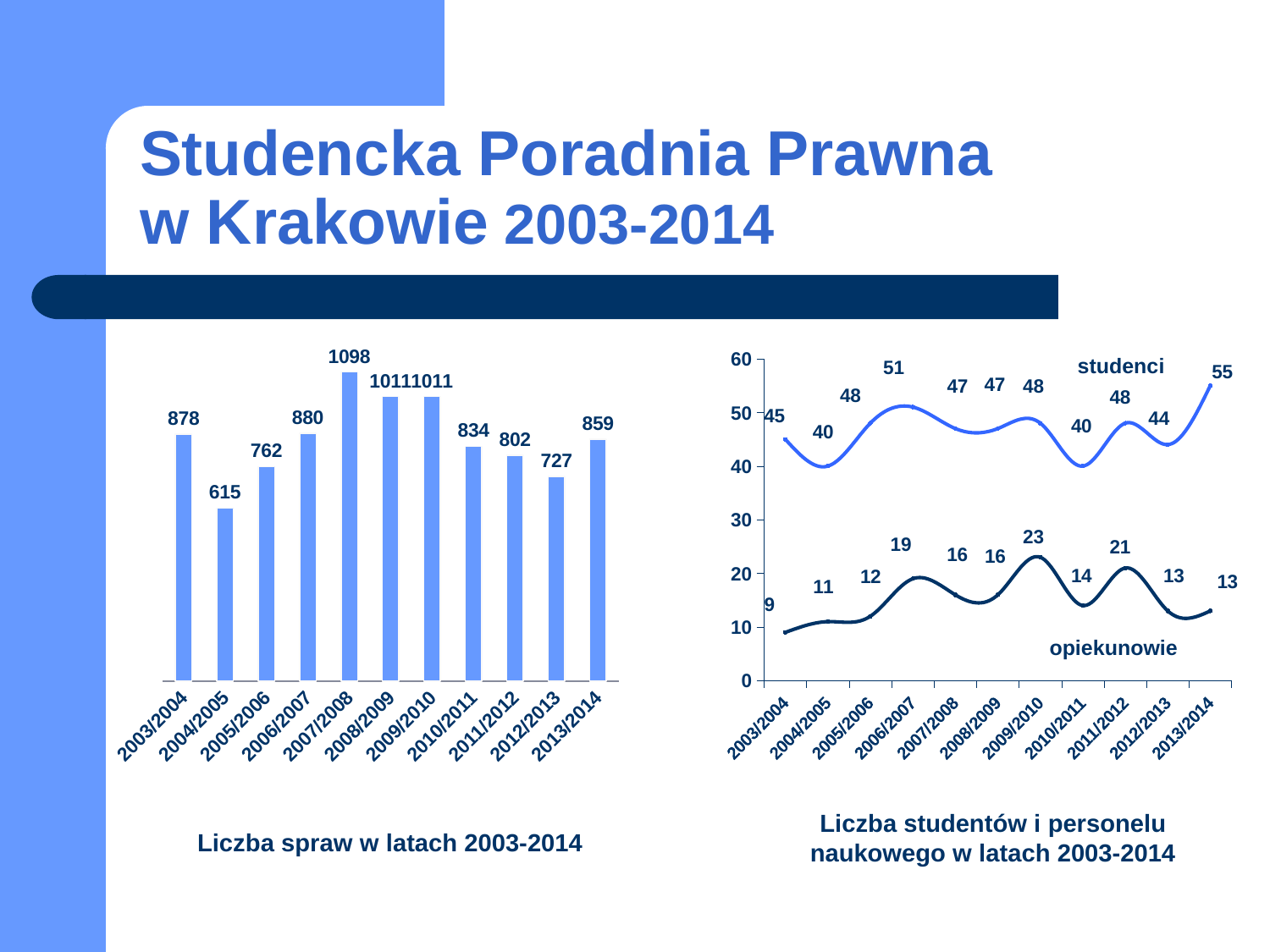
What kind of chart is the right chart (Liczba studentów i personelu naukowego)? line chart What kind of chart is the left chart (Liczba spraw w latach 2003-2014)? bar chart In the left chart (Liczba spraw w latach 2003-2014), which is larger, the value for 2003/2004 or the value for 2006/2007? 2006/2007 In the right chart (Liczba studentów i personelu naukowego), which year has the lowest value for opiekunowie? 2003/2004 In the left chart (Liczba spraw w latach 2003-2014), which year has the lowest value? 2004/2005 In the right chart (Liczba studentów i personelu naukowego), what is the value for opiekunowie in 2009/2010? 23 In the left chart (Liczba spraw w latach 2003-2014), what is the difference between the values for 2007/2008 and 2004/2005? 483 In the right chart (Liczba studentów i personelu naukowego), what is the value for studenci in 2013/2014? 55 In the right chart (Liczba studentów i personelu naukowego), how many series are plotted? 2 In the left chart (Liczba spraw w latach 2003-2014), how many years are shown? 11 In the right chart (Liczba studentów i personelu naukowego), what is the difference between studenci and opiekunowie in 2003/2004? 36 In the left chart (Liczba spraw w latach 2003-2014), what is the value for 2007/2008? 1098